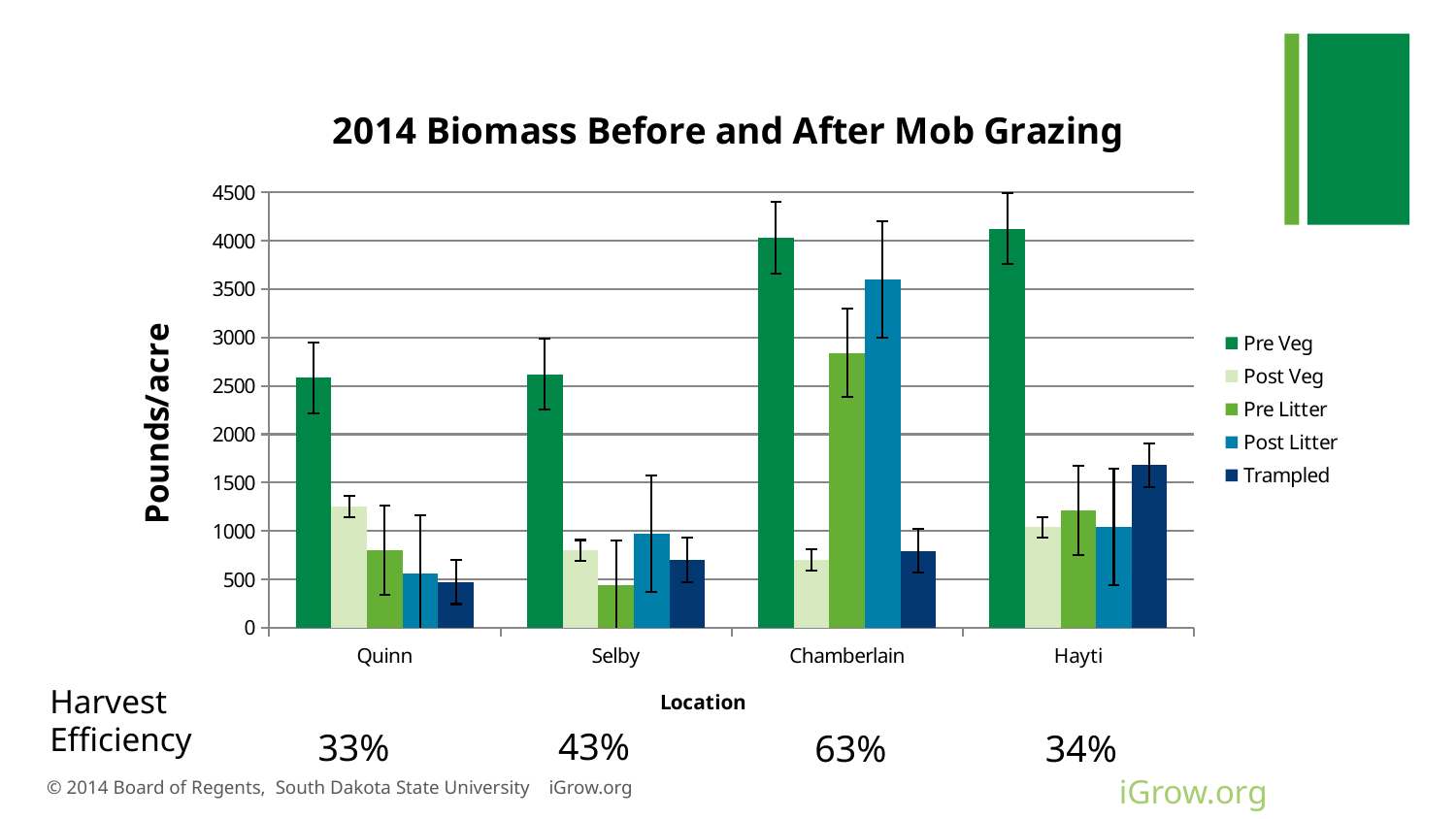
What is the title of the y axis? Pounds/acre Which location has the highest Post Litter value? Chamberlain Which location has the lowest Pre Litter value? Selby At Hayti, which is larger: Trampled or Post Litter? Trampled What is the harvest efficiency shown for Chamberlain? 63% What type of chart is shown on the slide? bar chart Is the Trampled value for Quinn greater or less than 1000? less Is the Post Litter value for Selby greater or less than 1500? less How many locations are shown on the x axis? 4 At Quinn, which is larger: Post Veg or Pre Litter? Post Veg Is the Pre Veg value for Chamberlain greater or less than 3500? greater How many series does the legend list? 5